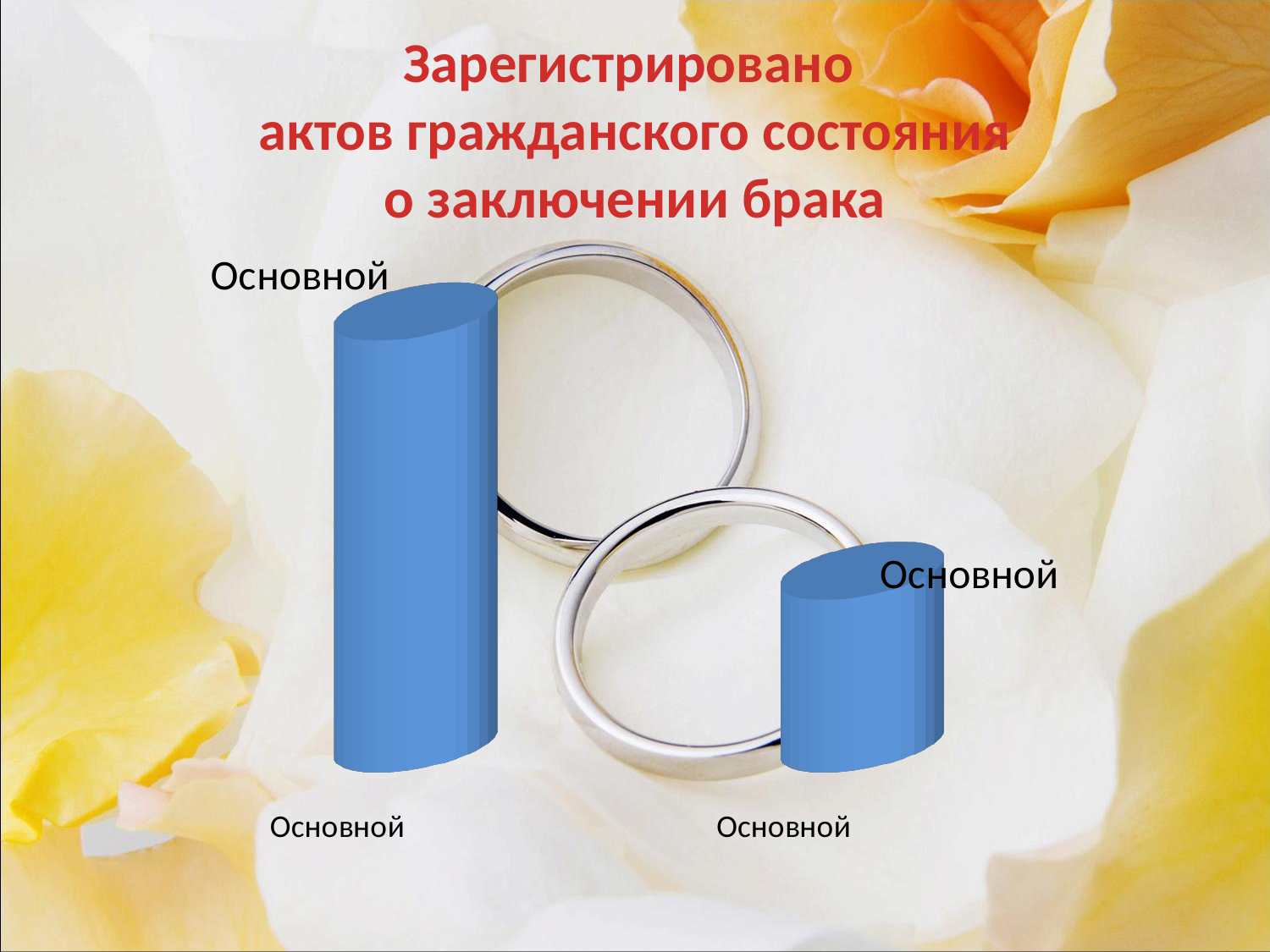
Do the values rise or fall from left to right across the chart? fall How many bars does the chart contain? 2 Which bar shows the highest value? the left bar Which bar is taller, the left one or the right one? the left one What is the title of the slide above the chart? Зарегистрировано актов гражданского состояния о заключении брака What kind of chart is shown on the slide? bar chart Which bar shows the lowest value? the right bar What text is shown as the data label above each bar? Основной